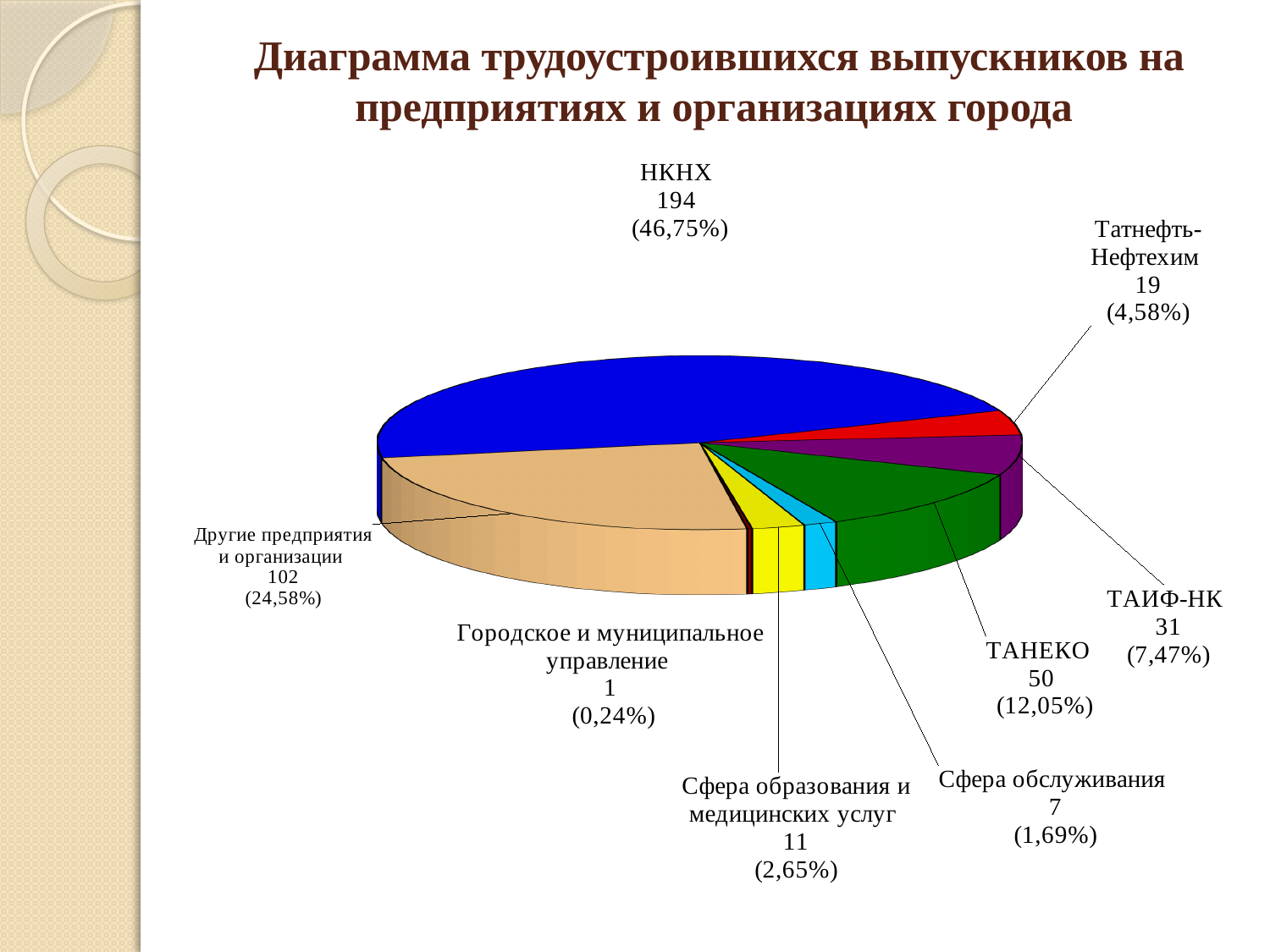
What colour is the НКНХ slice? blue What is the difference between the values for НКНХ and Другие предприятия и организации? 92 What is the value for НКНХ? 194 Which category has the smallest slice? Городское и муниципальное управление Which is larger, the value for Сфера образования и медицинских услуг or the value for Сфера обслуживания? Сфера образования и медицинских услуг What is the value for Татнефть-Нефтехим? 19 Which category has the largest slice? НКНХ What share of the pie does Другие предприятия и организации represent? 24,58% How many slices does the pie chart have? 8 What share of the pie does ТАИФ-НК represent? 7,47% What kind of chart is shown on the slide? pie chart What is the value for ТАНЕКО? 50